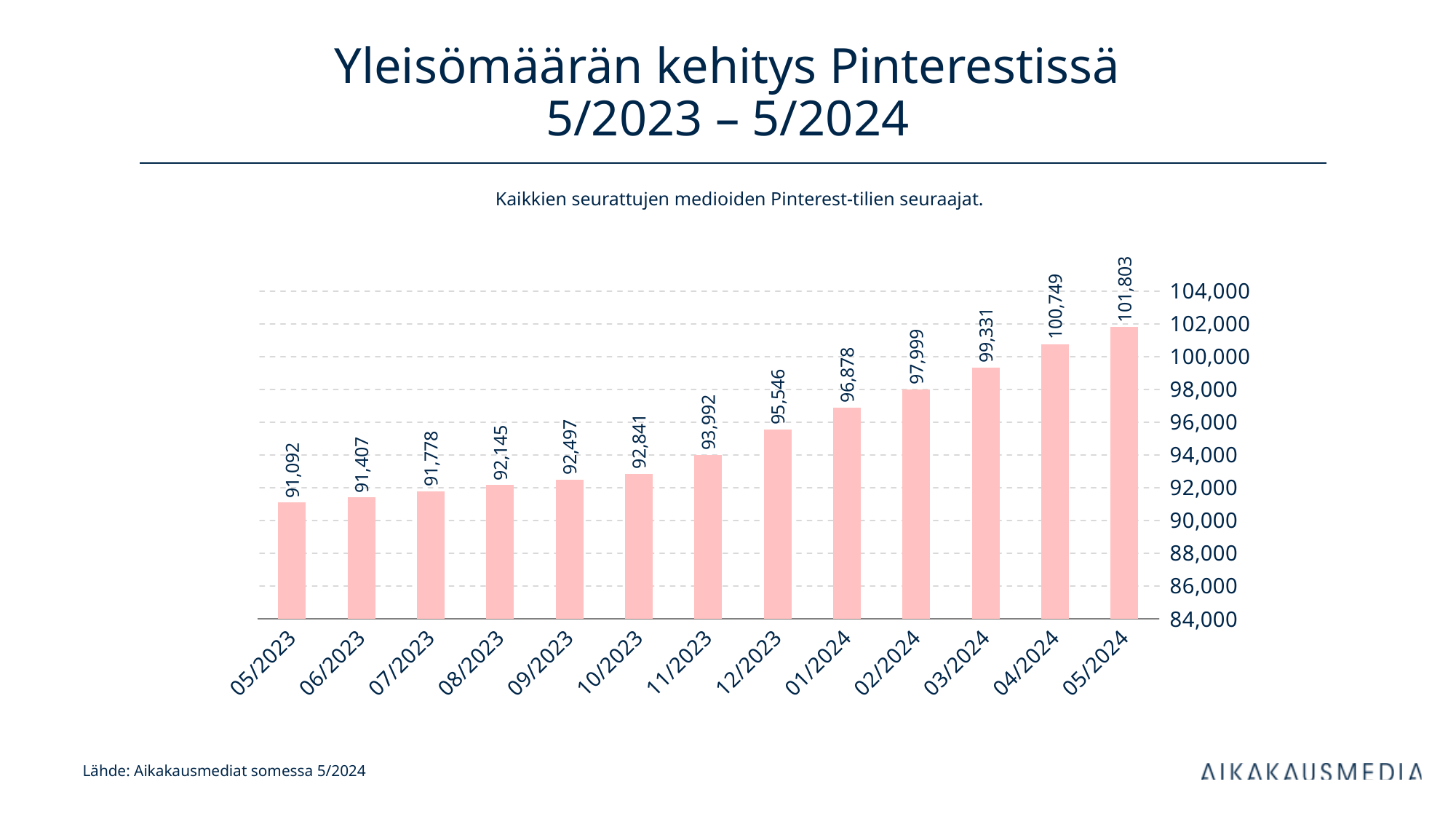
What kind of chart is shown on the slide? bar chart What is the difference between the values for 04/2024 and 03/2024? 1,418 Is the value for 02/2024 greater or less than 96,000? greater Which month has the lowest value? 05/2023 What is the value for 05/2023? 91,092 What is the value for 12/2023? 95,546 What is the difference between the values for 05/2024 and 05/2023? 10,711 Which is larger, the value for 11/2023 or the value for 01/2024? 01/2024 What is the value for 03/2024? 99,331 How many months are shown on the x axis? 13 Which month has the highest value? 05/2024 Do the values rise or fall from 05/2023 to 05/2024? rise